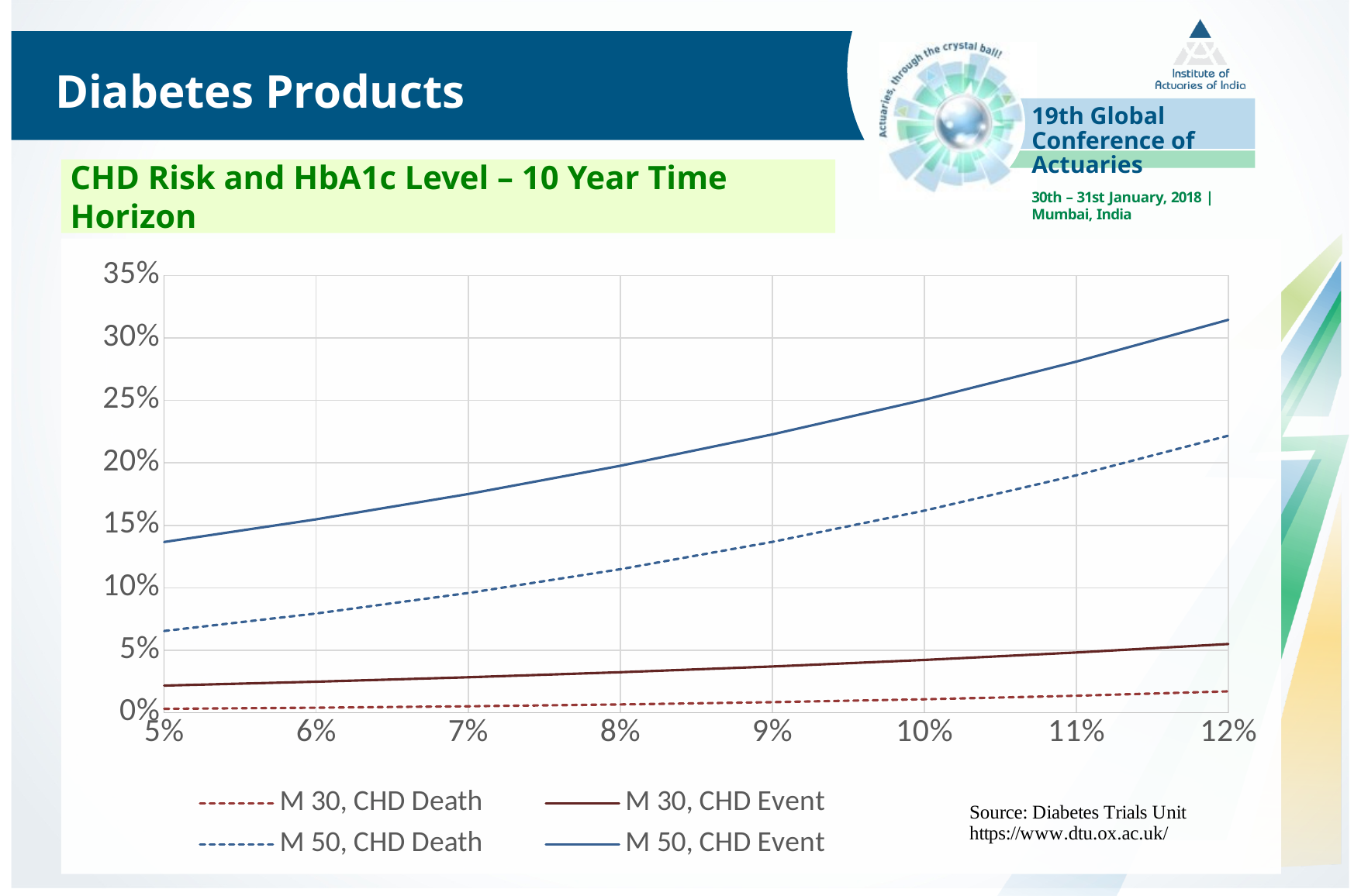
Which series has the highest values across the whole HbA1c range? M 50, CHD Event How many series does the legend list? 4 At an HbA1c level of 9%, which is larger: the value for M 50, CHD Death or the value for M 30, CHD Event? M 50, CHD Death Which series has the lowest values across the whole HbA1c range? M 30, CHD Death How many HbA1c levels are labelled on the x axis? 8 What is the title of the chart? CHD Risk and HbA1c Level – 10 Year Time Horizon What kind of chart is shown on the slide? Line chart Is the value for M 50, CHD Death at an HbA1c level of 12% greater or less than 20%? greater Is the value for M 50, CHD Event at an HbA1c level of 5% greater or less than 15%? less Is the value for M 30, CHD Death at an HbA1c level of 12% greater or less than 5%? less Do the values for M 50, CHD Event rise or fall as HbA1c increases from 5% to 12%? Rise